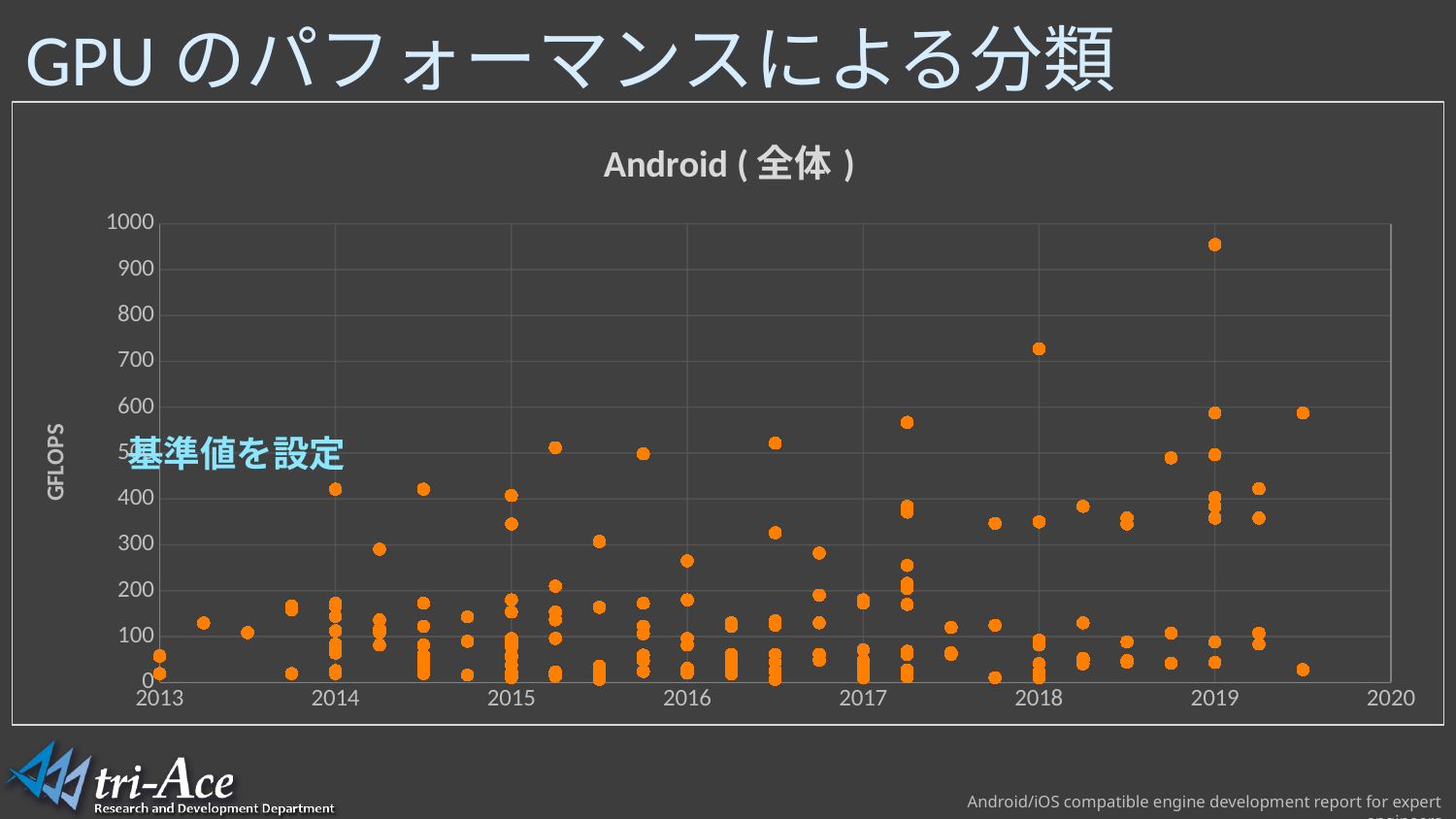
What is the first year label on the horizontal axis? 2013 What is the title of the chart? Android ( 全体 ) Is the highest plotted point, near 2019, greater or less than 900 GFLOPS? greater What is the maximum value shown on the vertical axis? 1000 Is the highest plotted point near 2013 greater or less than 100 GFLOPS? less What kind of chart is shown on the slide? Scatter chart Near which year is the highest plotted point located? 2019 What is the last year label on the horizontal axis? 2020 How many year labels are shown on the horizontal axis? 8 Do the highest plotted values generally rise or fall from 2013 to 2019? rise What is the label on the vertical axis of the chart? GFLOPS Is the highest plotted point near 2018 greater or less than 600 GFLOPS? greater